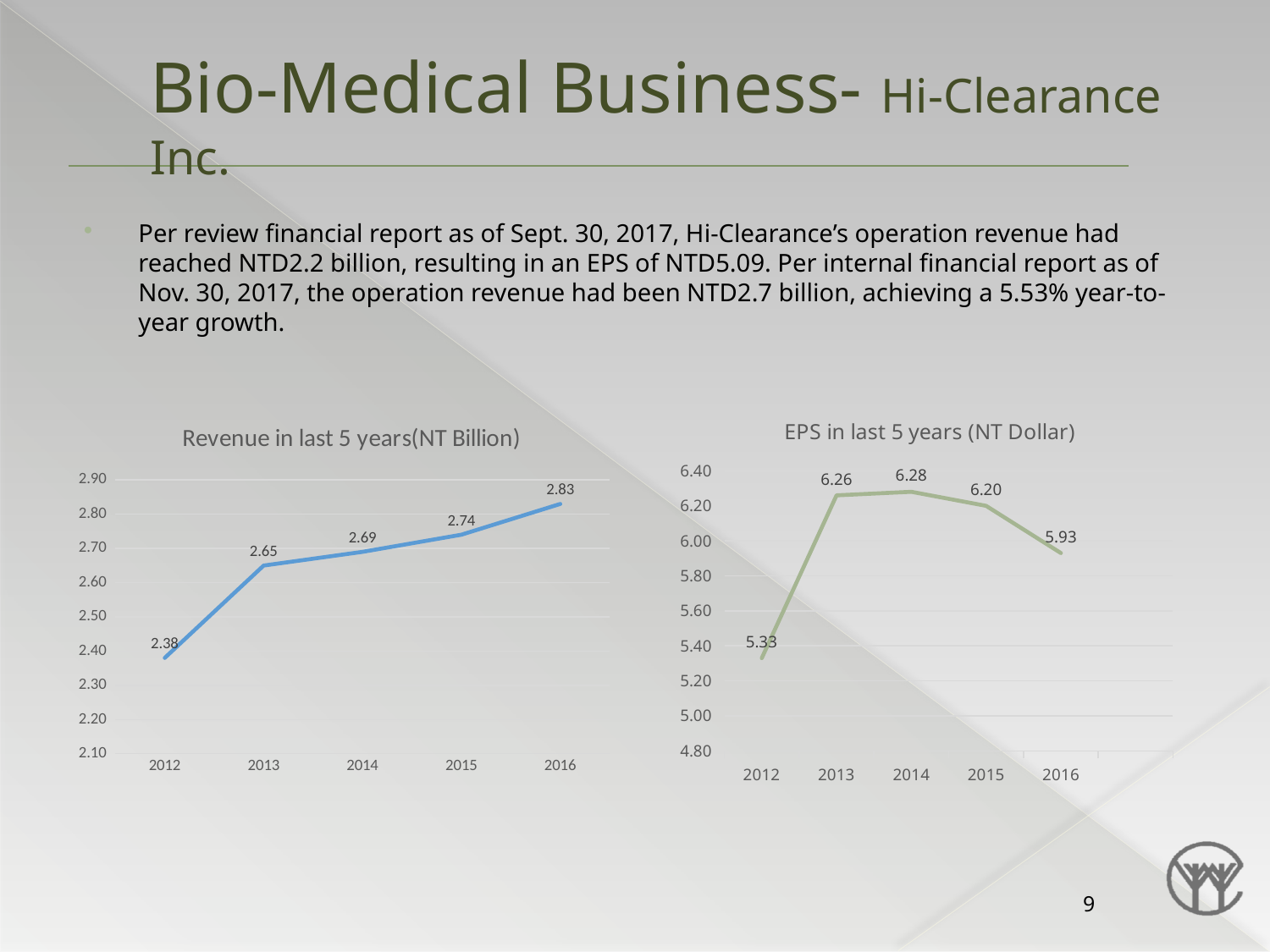
In the 'EPS in last 5 years (NT Dollar)' chart, what is the difference between the 2013 and 2016 EPS values? 0.33 In the 'Revenue in last 5 years(NT Billion)' chart, which year has the highest revenue? 2016 In the 'EPS in last 5 years (NT Dollar)' chart, which is larger, the EPS for 2013 or 2015? 2013 In the 'Revenue in last 5 years(NT Billion)' chart, what is the difference between the 2016 and 2012 revenue values? 0.45 In the 'Revenue in last 5 years(NT Billion)' chart, is the value for 2013 greater or less than 2.60? greater In the 'EPS in last 5 years (NT Dollar)' chart, which year has the highest EPS? 2014 In the 'EPS in last 5 years (NT Dollar)' chart, which year has the lowest EPS? 2012 In the 'EPS in last 5 years (NT Dollar)' chart, what is the EPS for 2016? 5.93 In the 'Revenue in last 5 years(NT Billion)' chart, do the values rise or fall from 2012 to 2016? Rise In the 'Revenue in last 5 years(NT Billion)' chart, what is the revenue for 2014? 2.69 How many years are plotted in the 'Revenue in last 5 years(NT Billion)' chart? 5 What kind of chart is the 'EPS in last 5 years (NT Dollar)' chart? Line chart